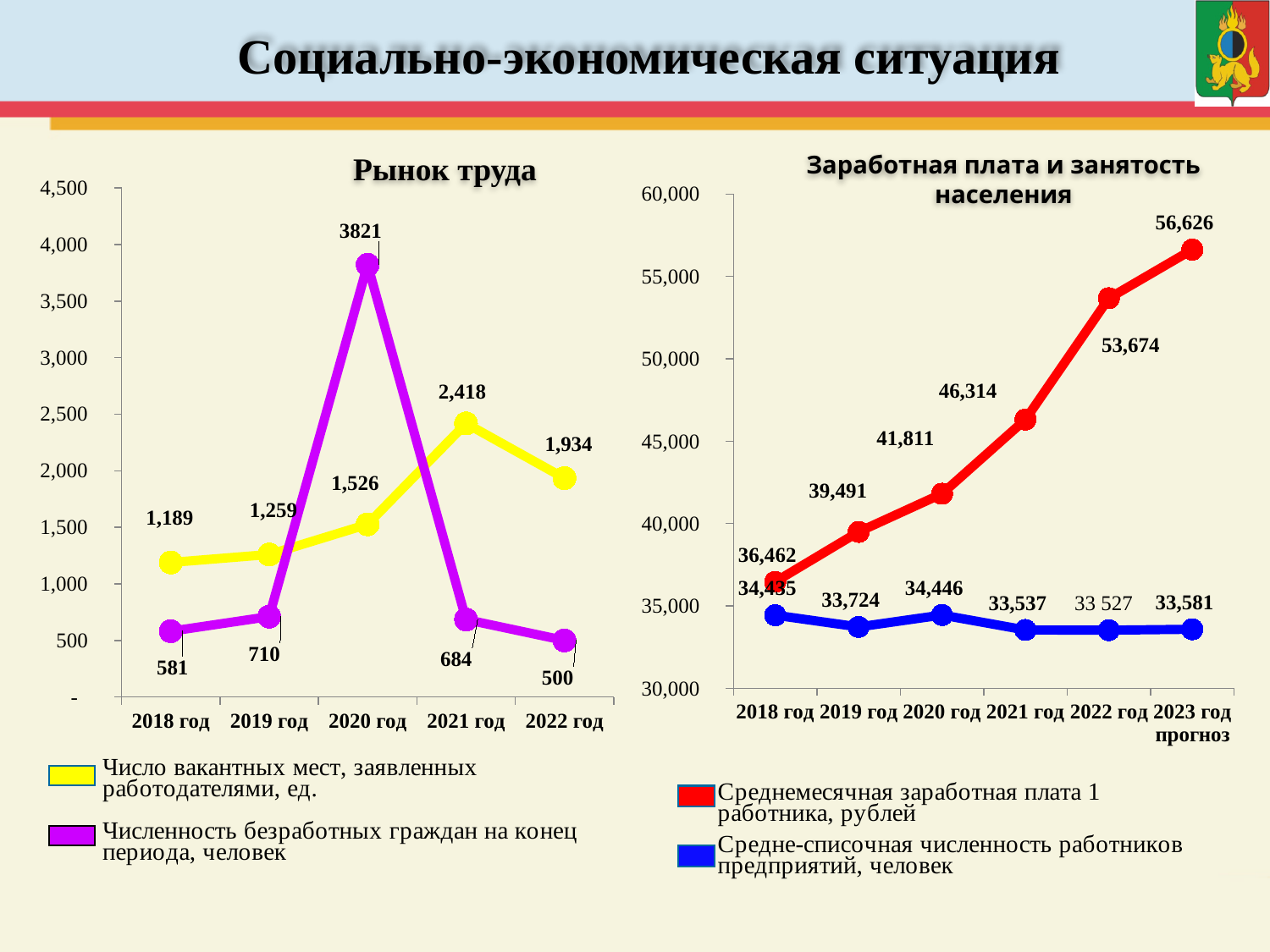
In the 'Рынок труда' chart, in which year is 'Численность безработных граждан на конец периода, человек' lowest? 2022 год In the 'Рынок труда' chart, in which year is 'Число вакантных мест, заявленных работодателями, ед.' highest? 2021 год In the 'Рынок труда' chart, what is the difference between the number of vacancies in 2021 год and 2022 год? 484 In the 'Заработная плата и занятость населения' chart, what is the difference between the average monthly salary in 2022 год and 2021 год? 7,360 In the 'Рынок труда' chart, what is the value of 'Число вакантных мест, заявленных работодателями, ед.' for 2021 год? 2,418 In the 'Заработная плата и занятость населения' chart, how many series does the legend list? 2 In the 'Рынок труда' chart, what is the value of 'Численность безработных граждан на конец периода, человек' for 2020 год? 3821 In the 'Заработная плата и занятость населения' chart, does 'Среднемесячная заработная плата 1 работника, рублей' rise or fall from 2018 год to 2023 год прогноз? rise In the 'Заработная плата и занятость населения' chart, what is the value of 'Средне-списочная численность работников предприятий, человек' for 2020 год? 34,446 In the 'Заработная плата и занятость населения' chart, what is the value of 'Среднемесячная заработная плата 1 работника, рублей' for 2023 год прогноз? 56,626 What type of chart is 'Рынок труда'? line chart In the 'Рынок труда' chart, how many years are shown on the x axis? 5